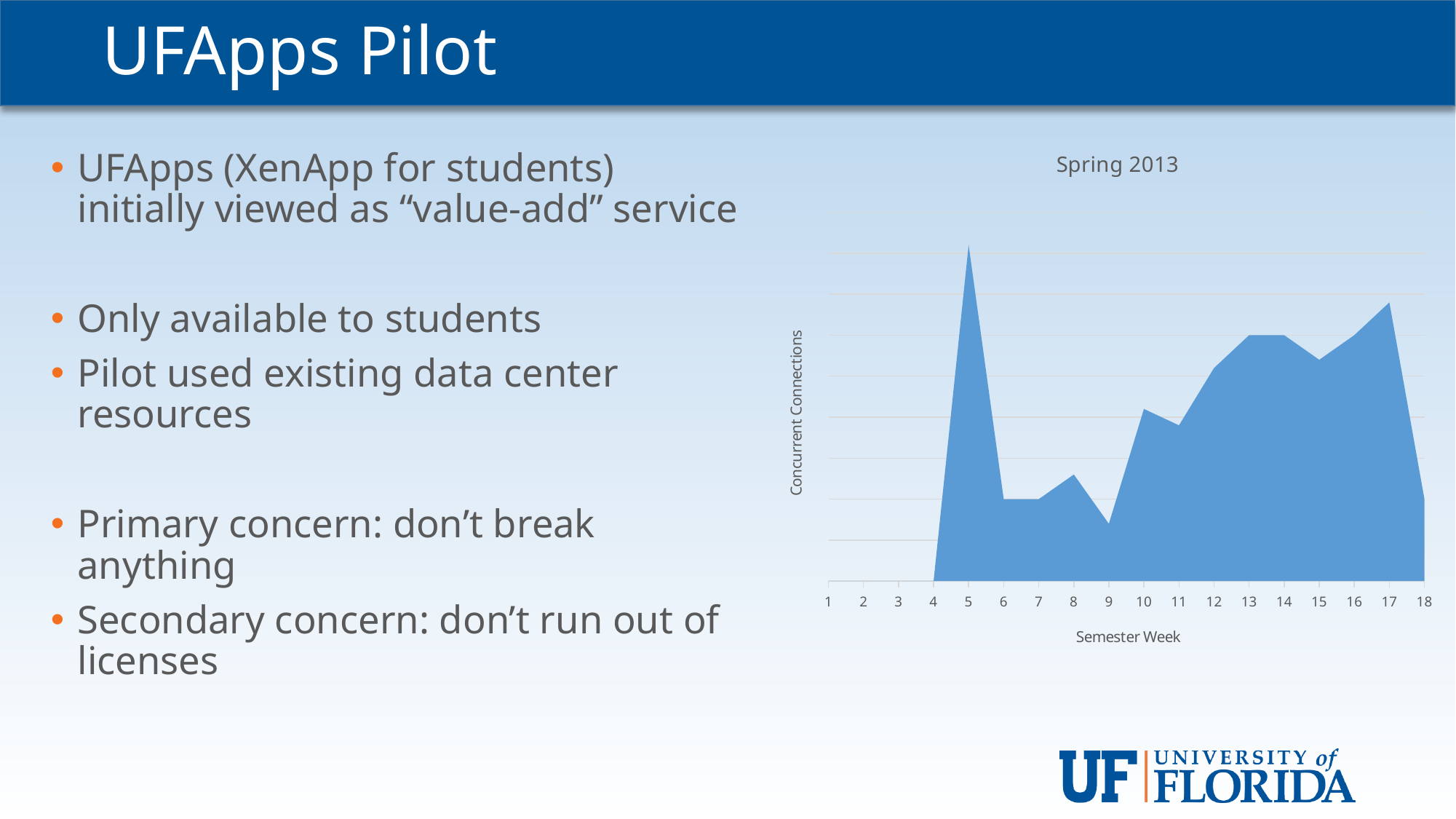
Which has more concurrent connections, semester week 5 or semester week 17? 5 How many semester weeks are labelled on the x axis of the chart? 18 Which has more concurrent connections, semester week 8 or semester week 9? 8 What is the title of the chart? Spring 2013 Between semester weeks 6 and 17, which week has the lowest number of concurrent connections? 9 Do concurrent connections rise or fall from semester week 9 to semester week 13? rise Which has more concurrent connections, semester week 6 or semester week 13? 13 Do concurrent connections rise or fall from semester week 5 to semester week 6? fall Which semester week has the highest number of concurrent connections? 5 What kind of chart is shown on the slide? area chart What is the label of the chart's vertical axis? Concurrent Connections